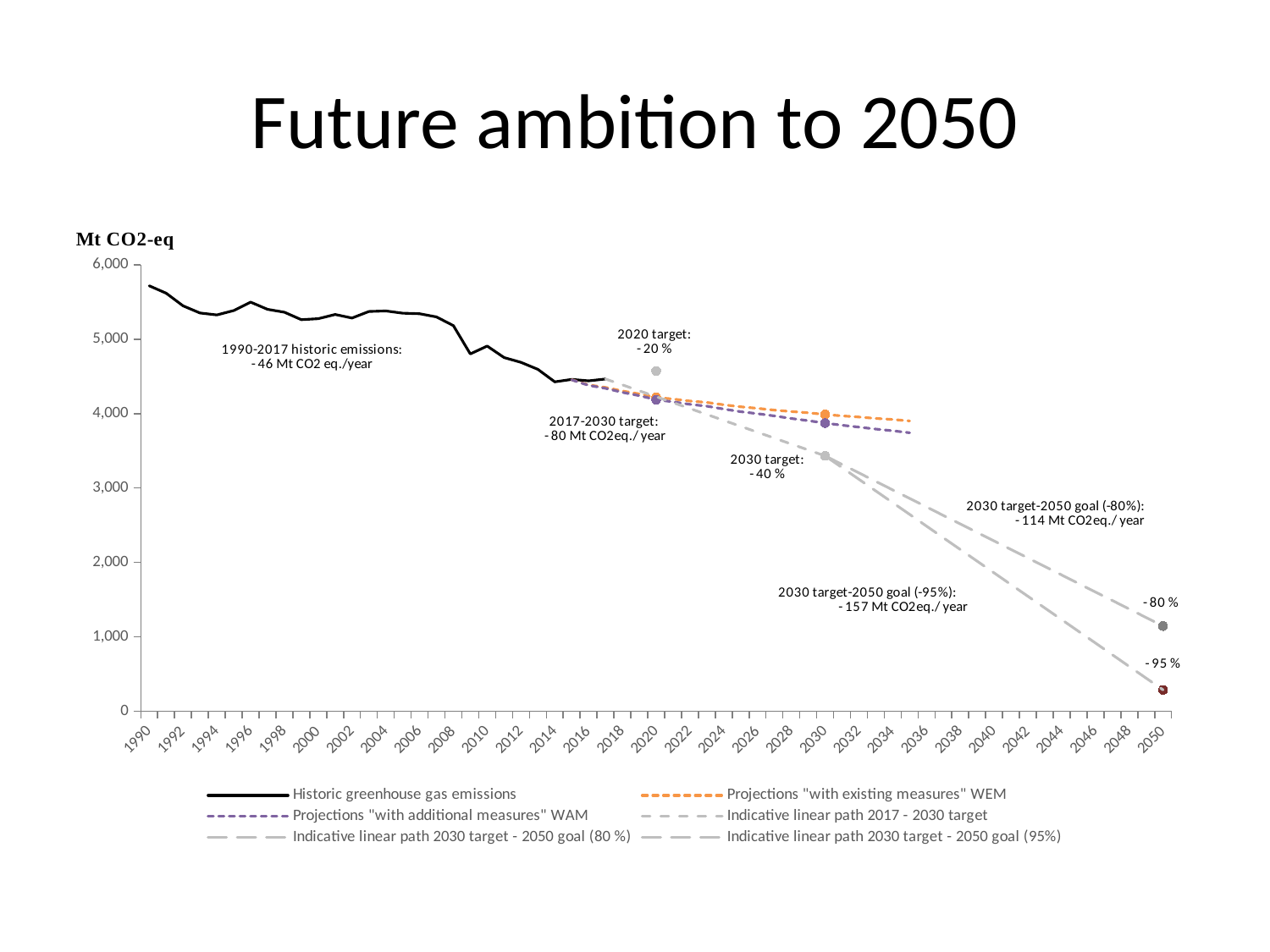
What unit is given for the vertical axis of the chart? Mt CO2-eq What annual reduction rate is shown for the path from the 2030 target to the 2050 goal of -95%? -157 Mt CO2eq./year In 2050, which goal point is higher on the chart, the -80 % goal or the -95 % goal? -80 % What annual reduction rate does the chart give for the 2017-2030 target path? -80 Mt CO2eq./year What percentage reduction is labelled as the 2020 target? -20 % What percentage reduction is labelled as the 2030 target? -40 % According to the chart annotation, what was the annual rate of change of historic emissions from 1990 to 2017? -46 Mt CO2 eq./year What annual reduction rate is shown for the path from the 2030 target to the 2050 goal of -80%? -114 Mt CO2eq./year Do the historic greenhouse gas emissions rise or fall overall between 1990 and 2017? fall Is the historic greenhouse gas emissions value in 1990 greater or less than 5,000? greater What kind of chart is shown on the slide? line chart How many series does the chart legend list? 6